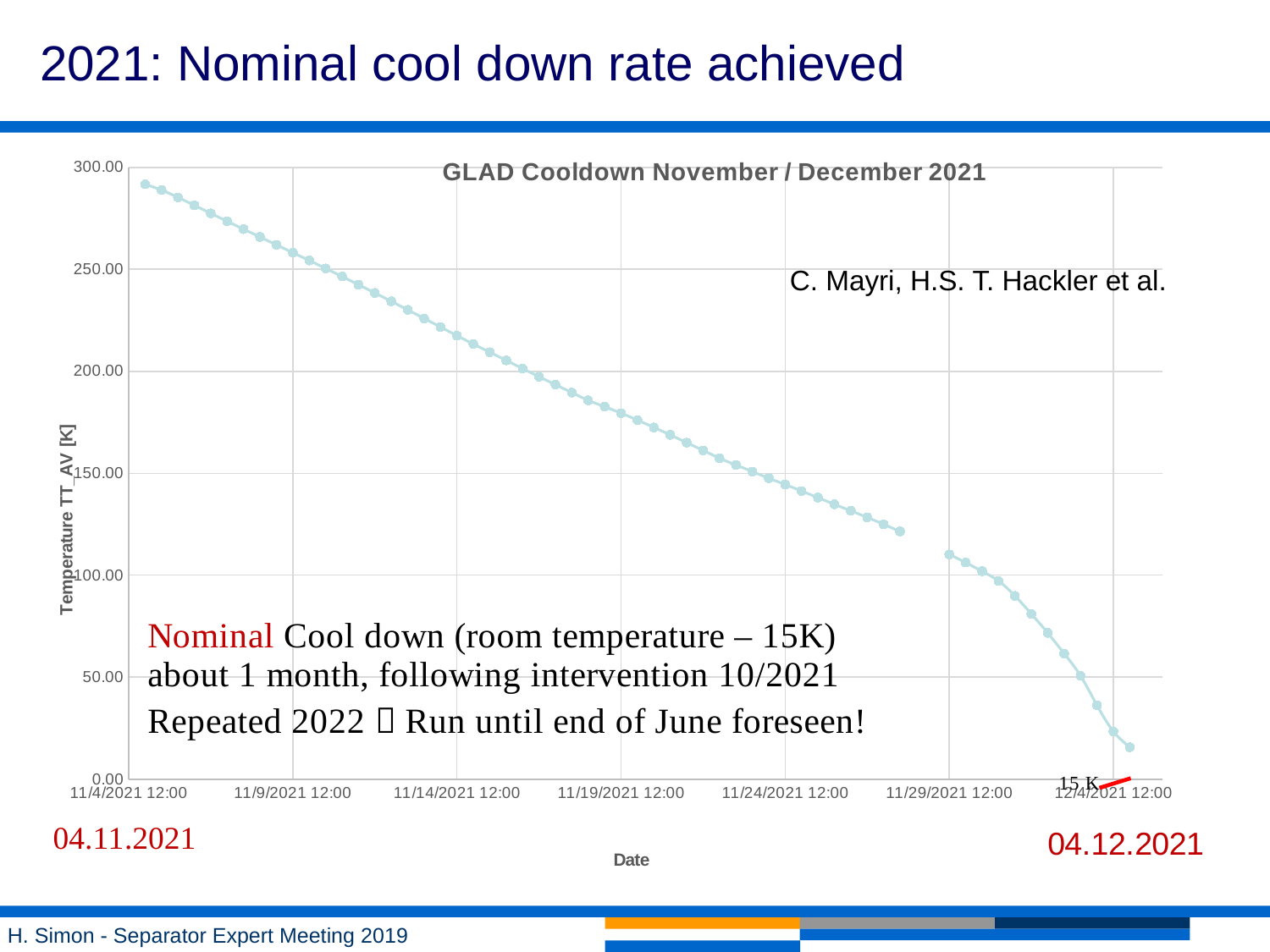
What kind of chart is shown on the slide? line chart At which x-axis date is the plotted temperature highest? 11/4/2021 12:00 Is the temperature at 11/14/2021 12:00 greater or less than 200? greater Is the temperature at 11/19/2021 12:00 greater or less than 150? greater What is the title of the chart? GLAD Cooldown November / December 2021 Is the temperature at the last plotted point near 12/4/2021 greater or less than 50? less What is the label of the y axis? Temperature TT_AV [K] Which is larger, the temperature at 11/9/2021 12:00 or at 11/24/2021 12:00? 11/9/2021 12:00 Do the plotted temperature values rise or fall along the x axis from 11/4/2021 to 12/4/2021? fall